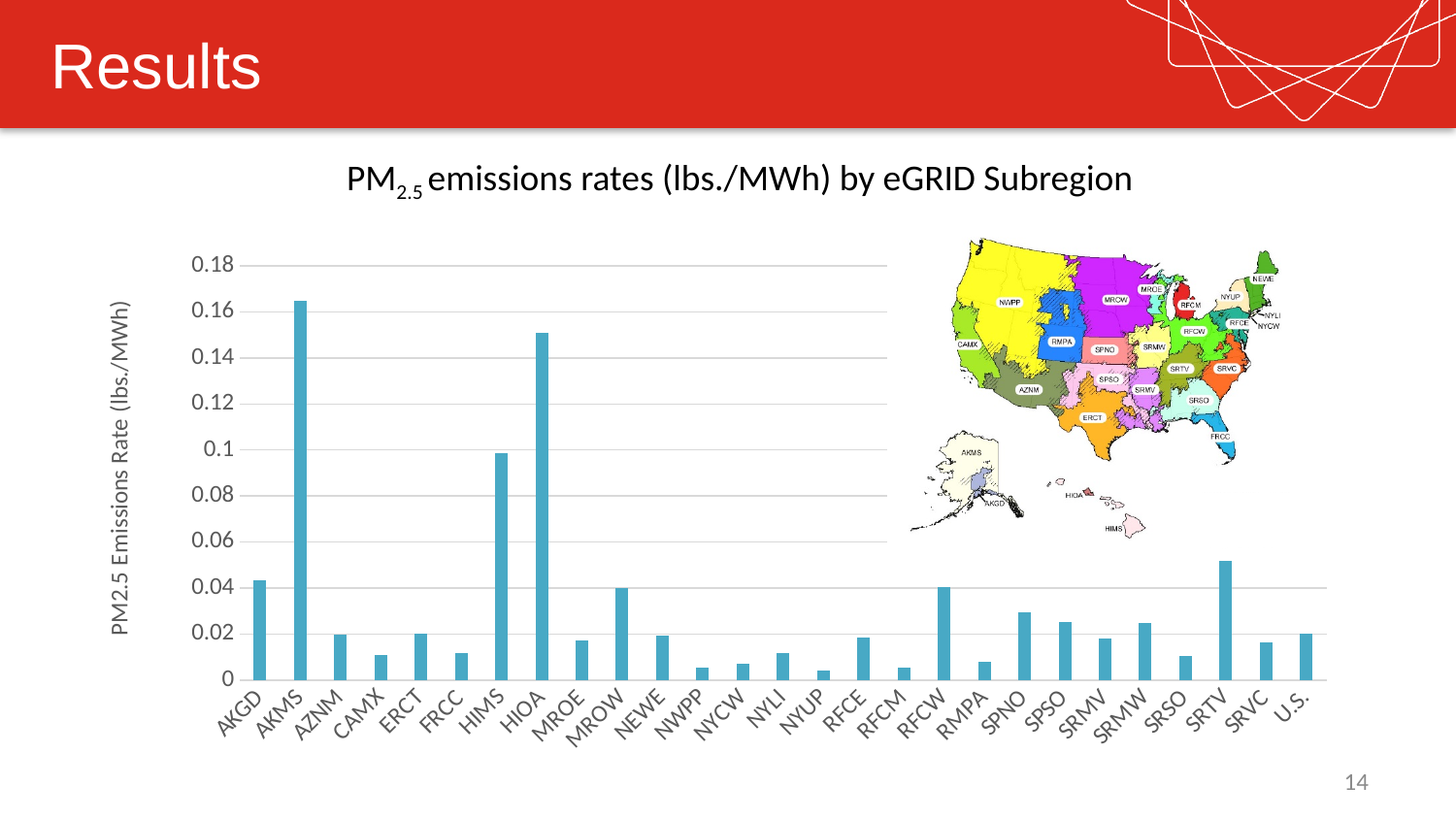
Is the value for SRTV greater or less than 0.04? greater Which subregion has the highest PM2.5 emissions rate? AKMS Which has a higher PM2.5 emissions rate, RFCW or SPNO? RFCW Is the value for HIMS greater or less than 0.08? greater What is the title of the chart? PM2.5 emissions rates (lbs./MWh) by eGRID Subregion Is the value for AKMS greater or less than 0.14? greater Which has a higher PM2.5 emissions rate, AKMS or HIOA? AKMS What is the label on the vertical axis of the chart? PM2.5 Emissions Rate (lbs./MWh) What kind of chart is shown on the slide? bar chart How many categories (bars) are plotted along the x axis? 27